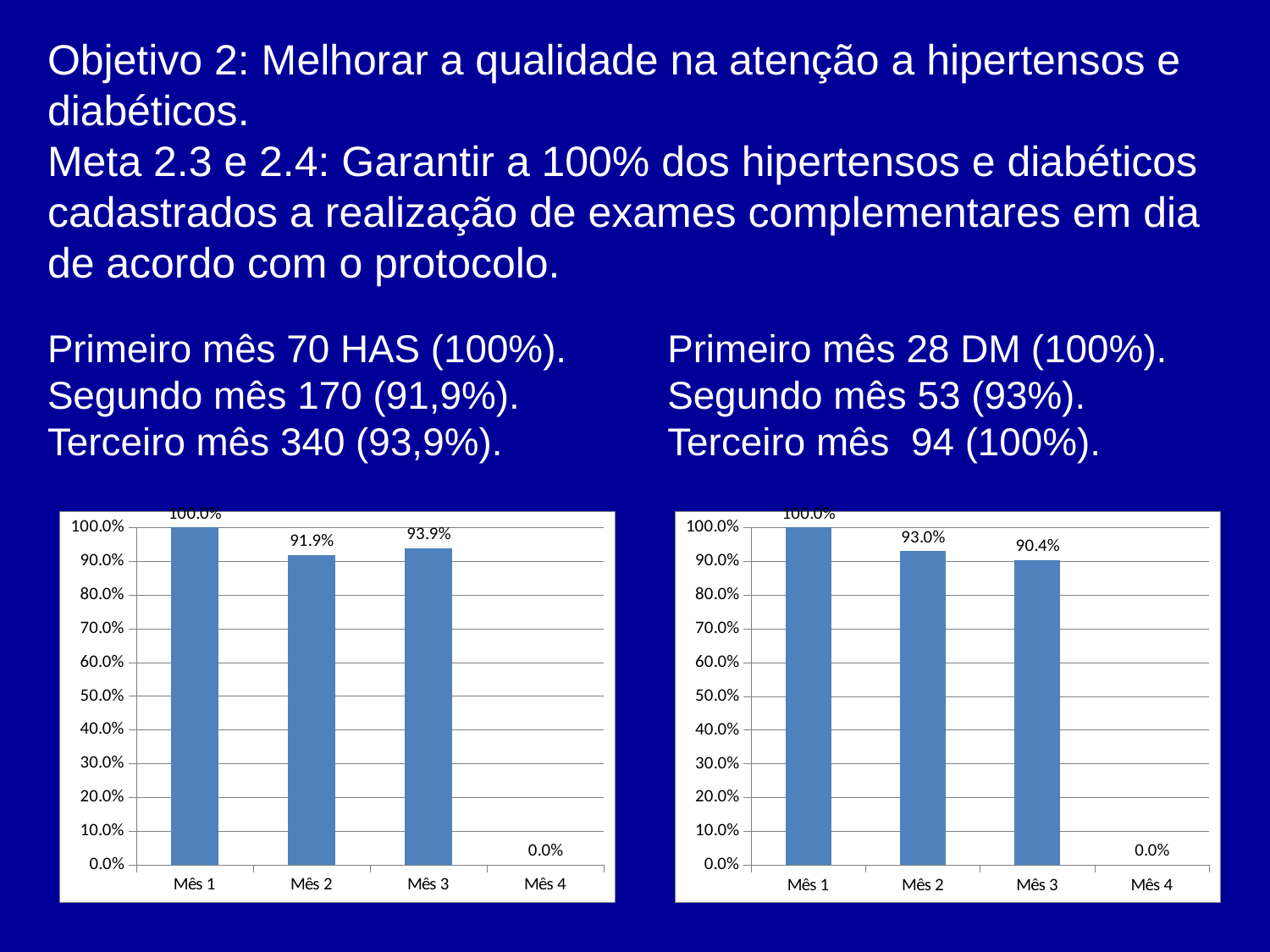
In the left chart, what is the value for Mês 3? 93.9% In the left chart, what is the difference between the values for Mês 3 and Mês 2? 2.0% In the right chart, what is the value for Mês 2? 93.0% In the right chart, which month has the lowest value? Mês 4 In the right chart, which is larger, the value for Mês 2 or the value for Mês 3? Mês 2 What type of chart is the right chart? Bar chart In the right chart, do the values rise or fall from Mês 1 to Mês 3? Fall In the left chart, what is the value for Mês 2? 91.9% How many months are shown on the x axis of the left chart? 4 In the right chart, what is the value for Mês 3? 90.4% In the right chart, what is the value for Mês 4? 0.0% In the left chart, which month has the highest value? Mês 1